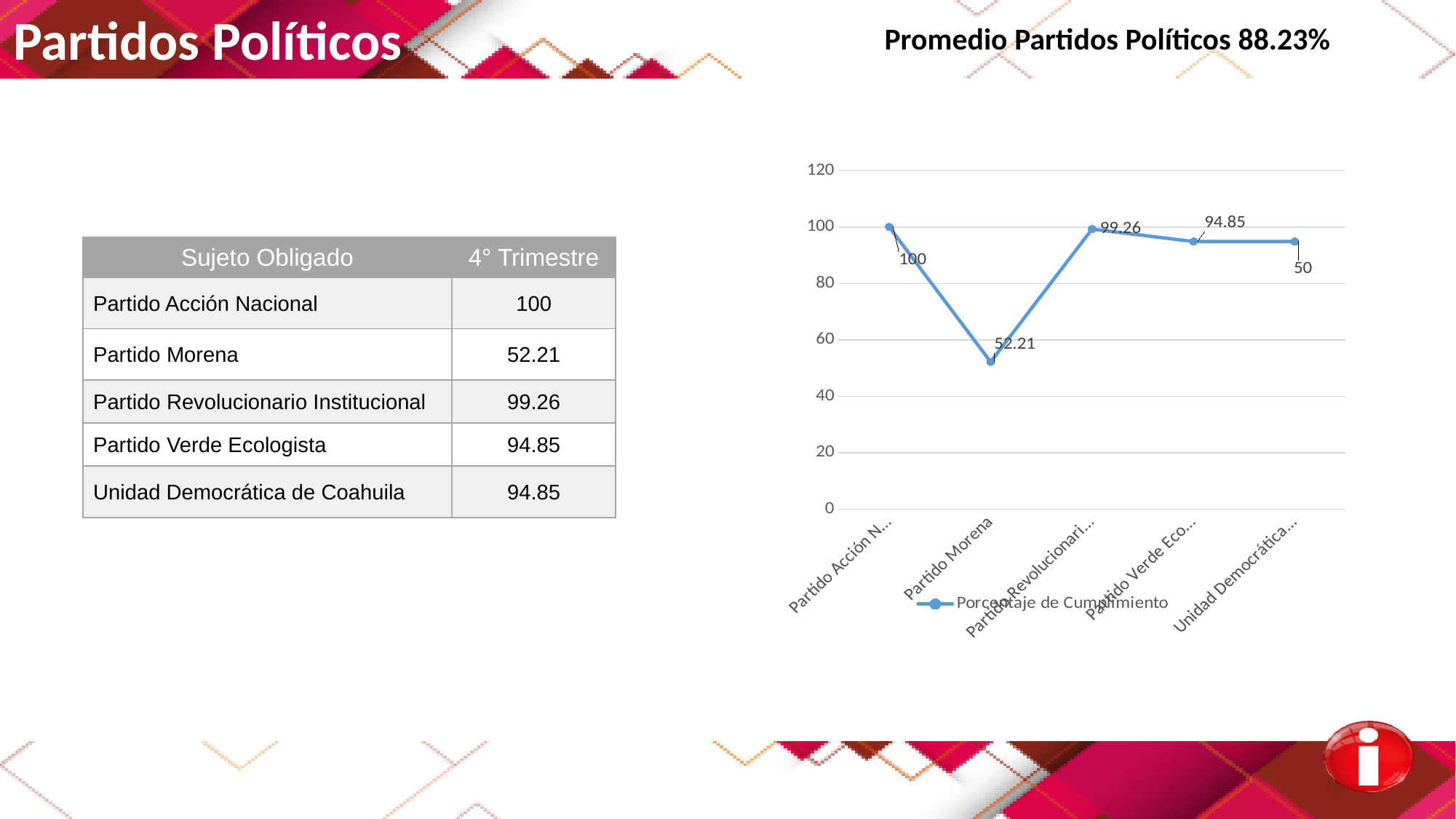
How many series does the legend list? 1 What is the value plotted for Partido Revolucionario Institucional? 99.26 Which category has the highest value on the chart? Partido Acción Nacional How many categories are plotted on the chart? 5 Which is larger, the value for Partido Morena or the value for Partido Verde Ecologista? Partido Verde Ecologista Which category has the lowest value on the chart? Partido Morena What is the name of the series shown in the legend? Porcentaje de Cumplimiento What is the difference between the values for Partido Acción Nacional and Partido Morena? 47.79 What is the value plotted for Partido Acción Nacional? 100 What is the value plotted for Partido Verde Ecologista? 94.85 What is the value plotted for Partido Morena? 52.21 What kind of chart is shown on the slide? line chart